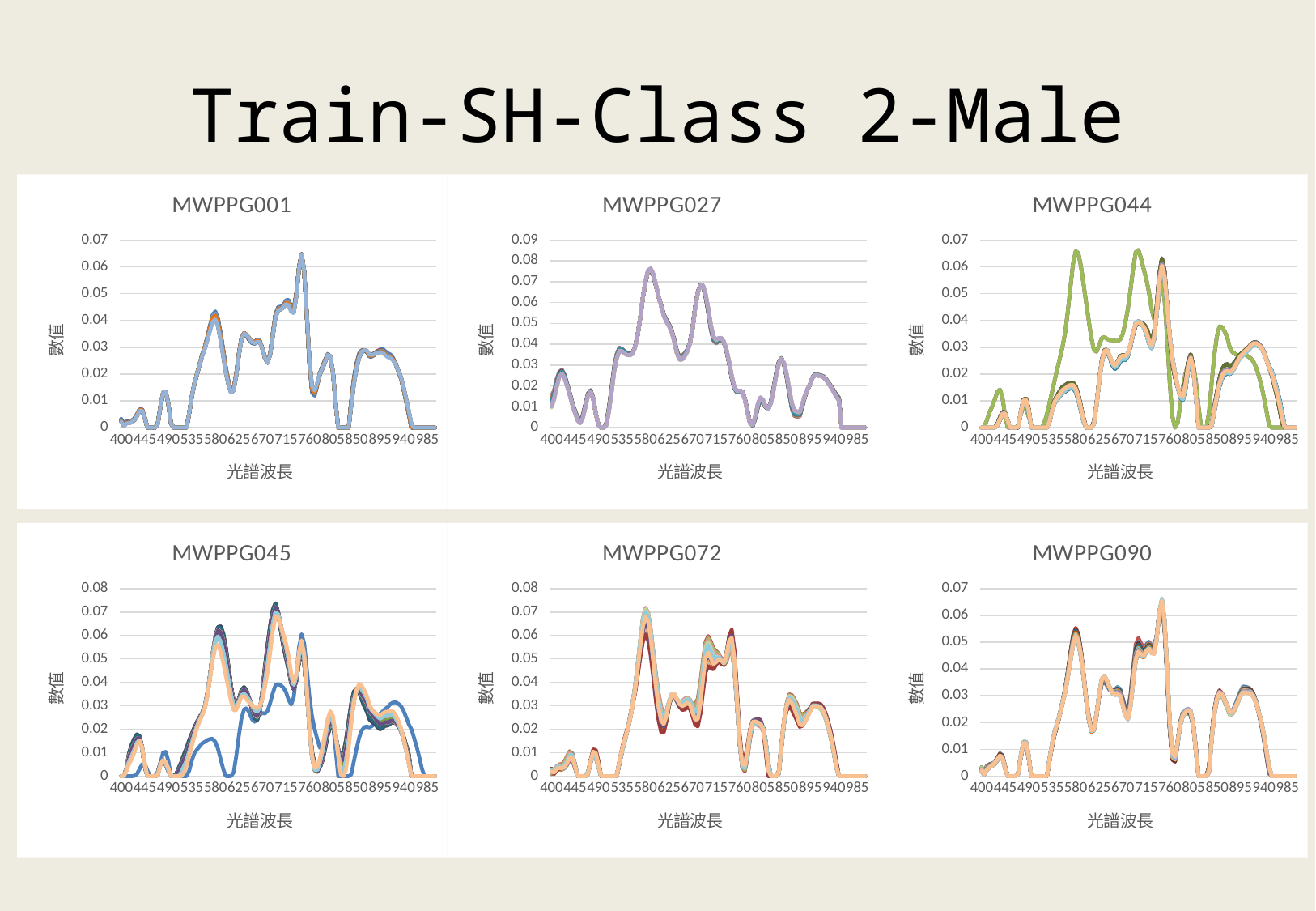
In the MWPPG001 chart, is the highest peak (near 760) greater or less than 0.06? greater In the MWPPG044 chart, is the value of the green line at 850 greater or less than 0.01? less How many charts are shown on the slide? 6 In the MWPPG027 chart, is the highest peak (near 580) greater or less than 0.07? greater What is the title of the x axis on the MWPPG072 chart? 光譜波長 What kind of chart is MWPPG001? line chart What is the highest value shown on the y axis of the MWPPG027 chart? 0.09